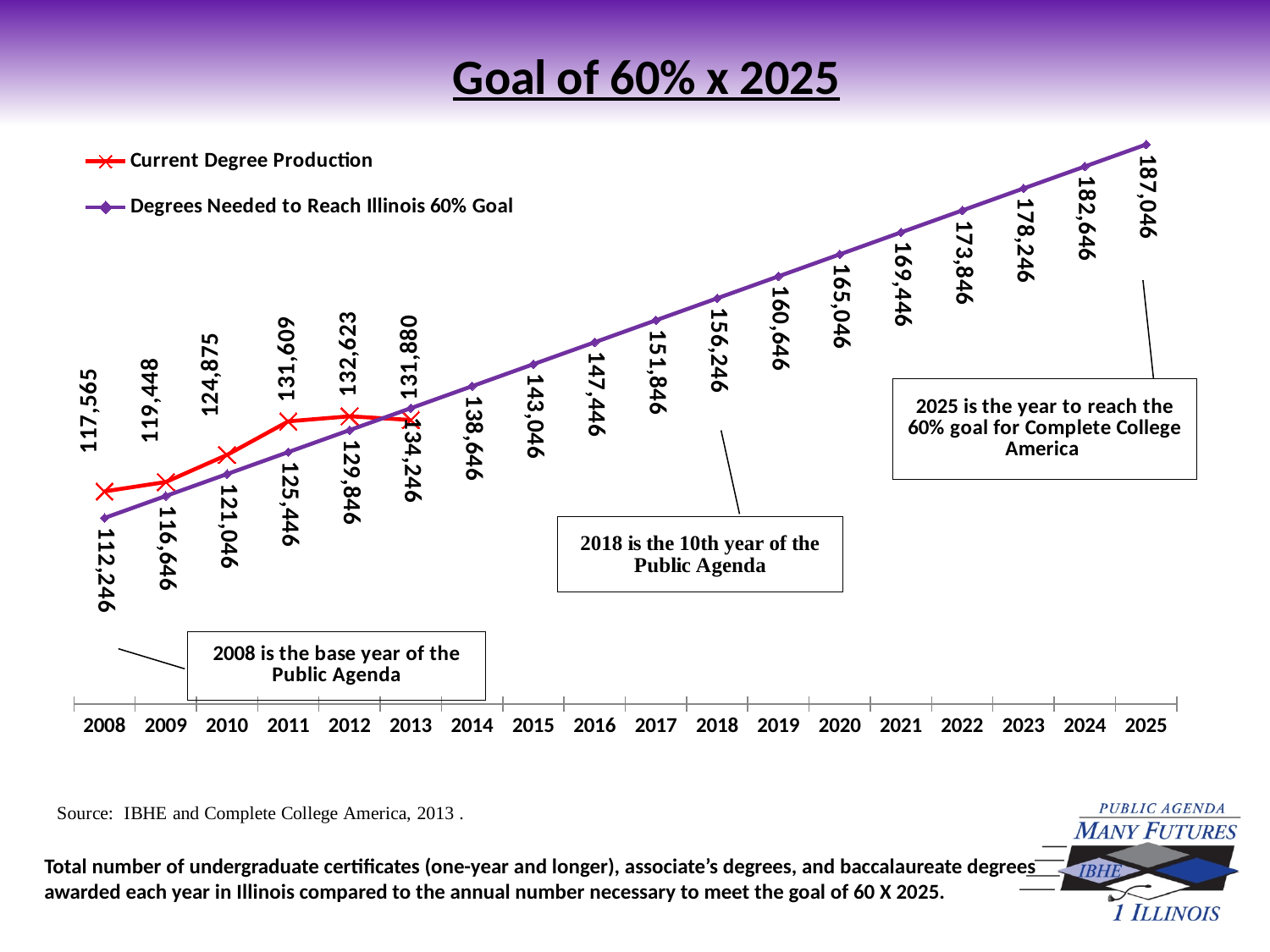
In which year is Current Degree Production highest? 2012 In 2010, which series has the larger value: Current Degree Production or Degrees Needed to Reach Illinois 60% Goal? Current Degree Production In which year is the Degrees Needed to Reach Illinois 60% Goal series lowest? 2008 How many years are shown on the x axis? 18 By how much does the Degrees Needed to Reach Illinois 60% Goal value increase from 2008 to 2025? 74,800 How many Degrees Needed to Reach Illinois 60% Goal are shown for 2025? 187,046 What is the Degrees Needed to Reach Illinois 60% Goal value for 2018? 156,246 What kind of chart is shown on the slide? Line chart How many series does the legend list? 2 What is the Current Degree Production value for 2012? 132,623 In 2013, how much larger is Degrees Needed to Reach Illinois 60% Goal than Current Degree Production? 2,366 What is the Current Degree Production value for 2008? 117,565